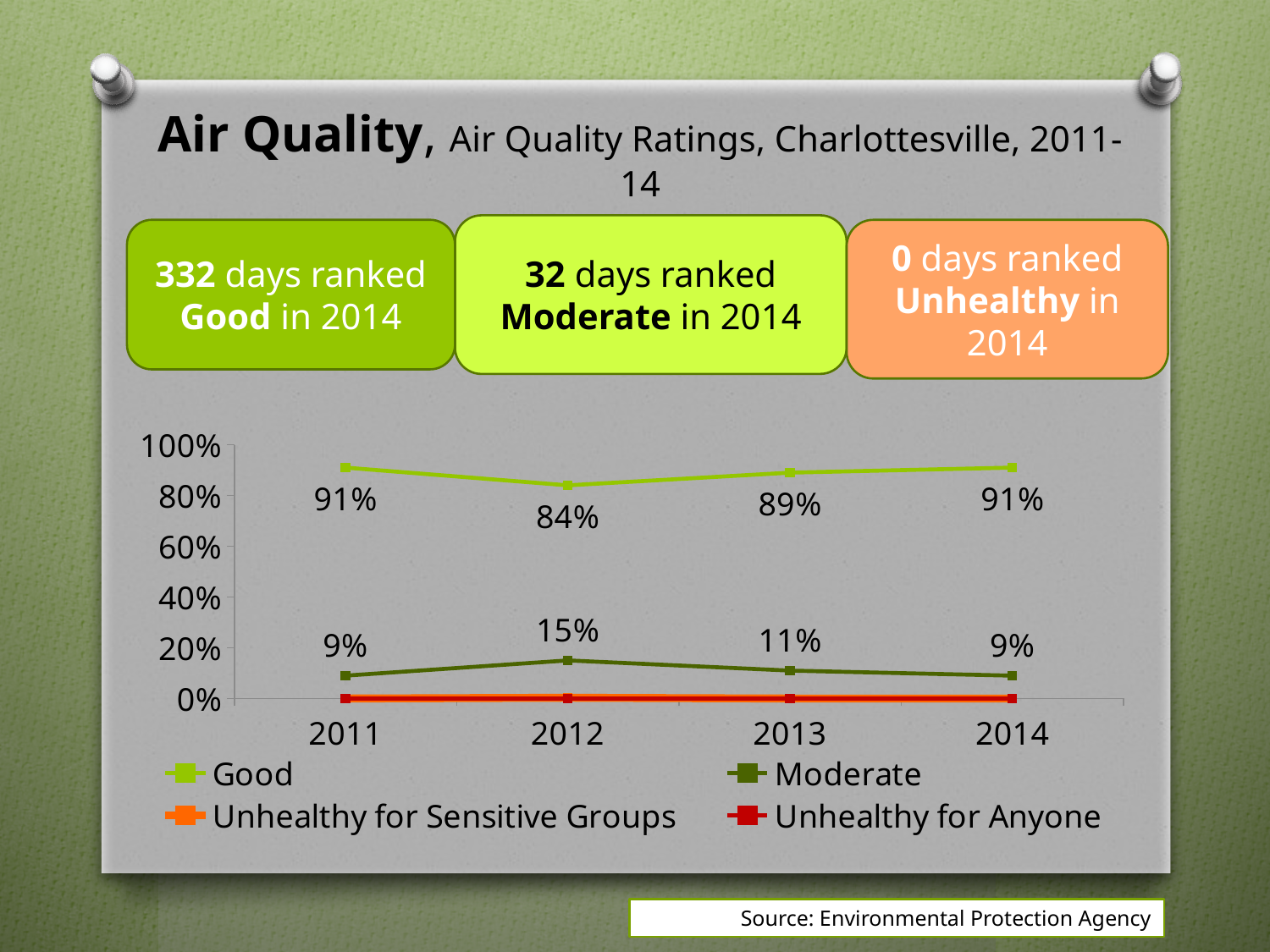
What is the difference between the Good share in 2011 and in 2012? 7% What is the difference between the Moderate share in 2012 and in 2014? 6% What kind of chart is shown? line chart In which year was the Moderate share highest? 2012 What percentage of days were ranked Good in 2012? 84% What percentage of days were ranked Moderate in 2013? 11% How many series does the legend list? 4 How many years are shown on the x axis? 4 Is the Moderate value for 2012 greater or less than 20%? less Which is larger, the Good share in 2013 or the Good share in 2014? 2014 In which year was the Good share lowest? 2012 Does the Good share rise or fall from 2012 to 2014? rise